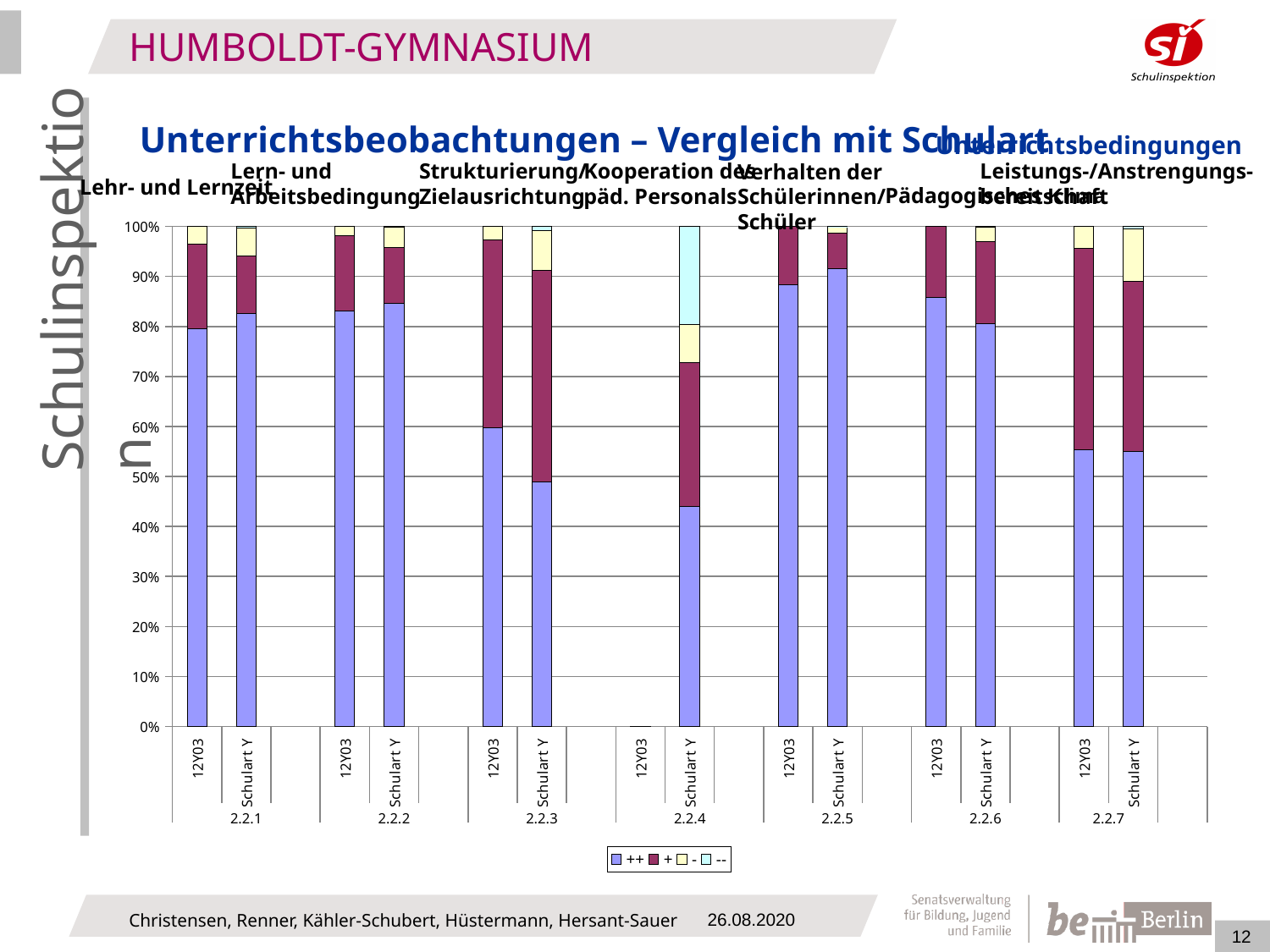
What are the four legend entries of the chart? ++, +, -, -- How many category groups (2.2.1 to 2.2.7) are shown on the x axis? 7 Is the '++' share for 12Y03 in category 2.2.7 greater or less than 60%? less In category 2.2.3, which bar has the larger '++' share, 12Y03 or Schulart Y? 12Y03 Is the '++' share for Schulart Y in category 2.2.4 greater or less than 50%? less What kind of chart is shown on the slide? Stacked bar chart Is the '++' share for 12Y03 in category 2.2.5 greater or less than 80%? greater For the Schulart Y bars, which category has the lowest '++' share? 2.2.4 How many series does the legend list? 4 Which two bars are shown within each category group? 12Y03 and Schulart Y In category 2.2.6, which bar has the larger '++' share, 12Y03 or Schulart Y? 12Y03